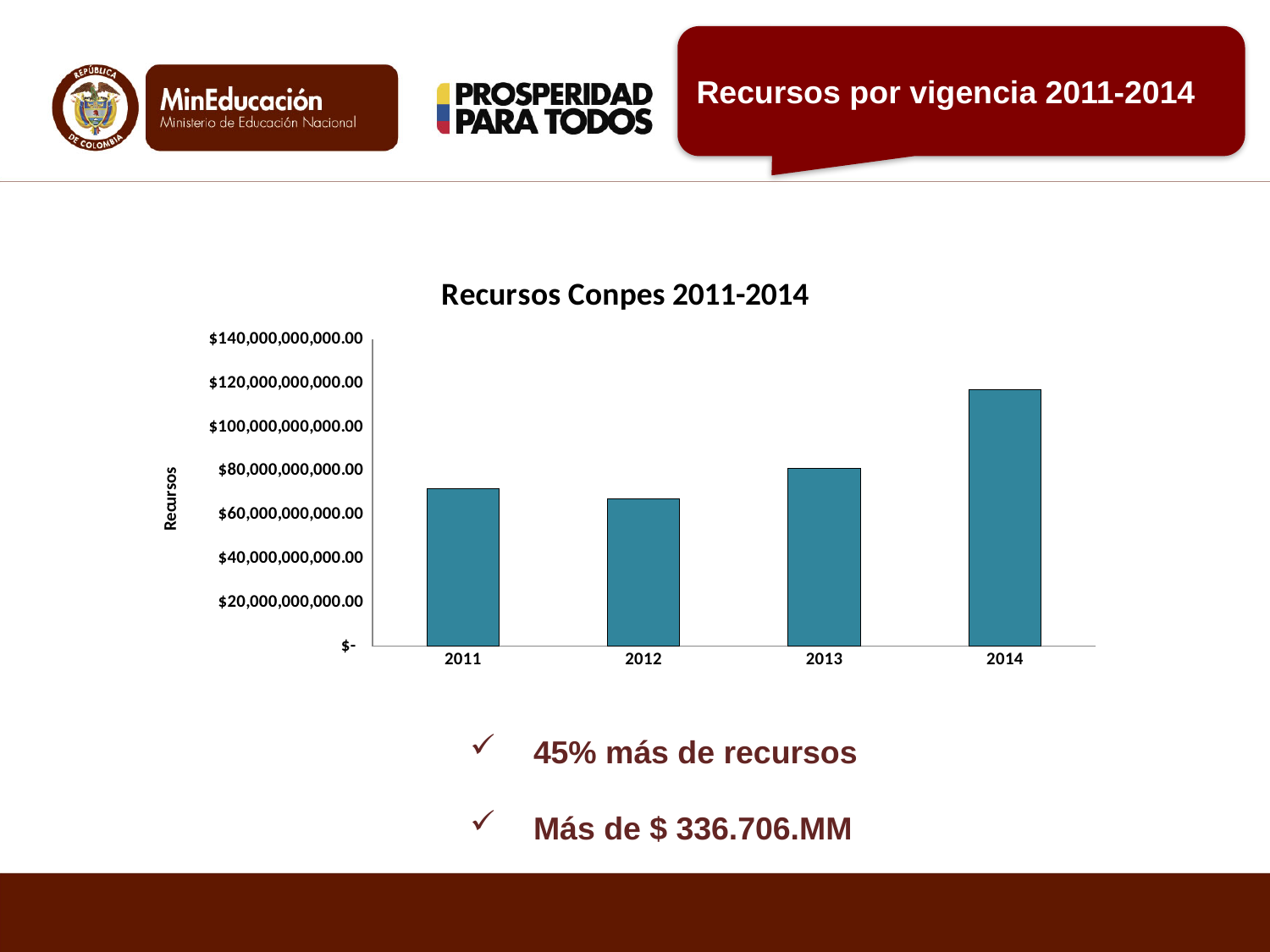
Does the value rise or fall from 2013 to 2014? rise What is the title of the chart? Recursos Conpes 2011-2014 Is the value for 2011 greater or less than $60,000,000,000.00? greater Which year has the larger value, 2013 or 2014? 2014 What type of chart is shown on the slide? Bar chart Is the value for 2014 greater or less than $100,000,000,000.00? greater Is the value for 2012 greater or less than $80,000,000,000.00? less Which year has the highest value in the chart? 2014 What is the label on the vertical axis of the chart? Recursos How many years (bars) are shown in the chart? 4 Which year has the larger value, 2011 or 2012? 2011 Which year has the lowest value in the chart? 2012